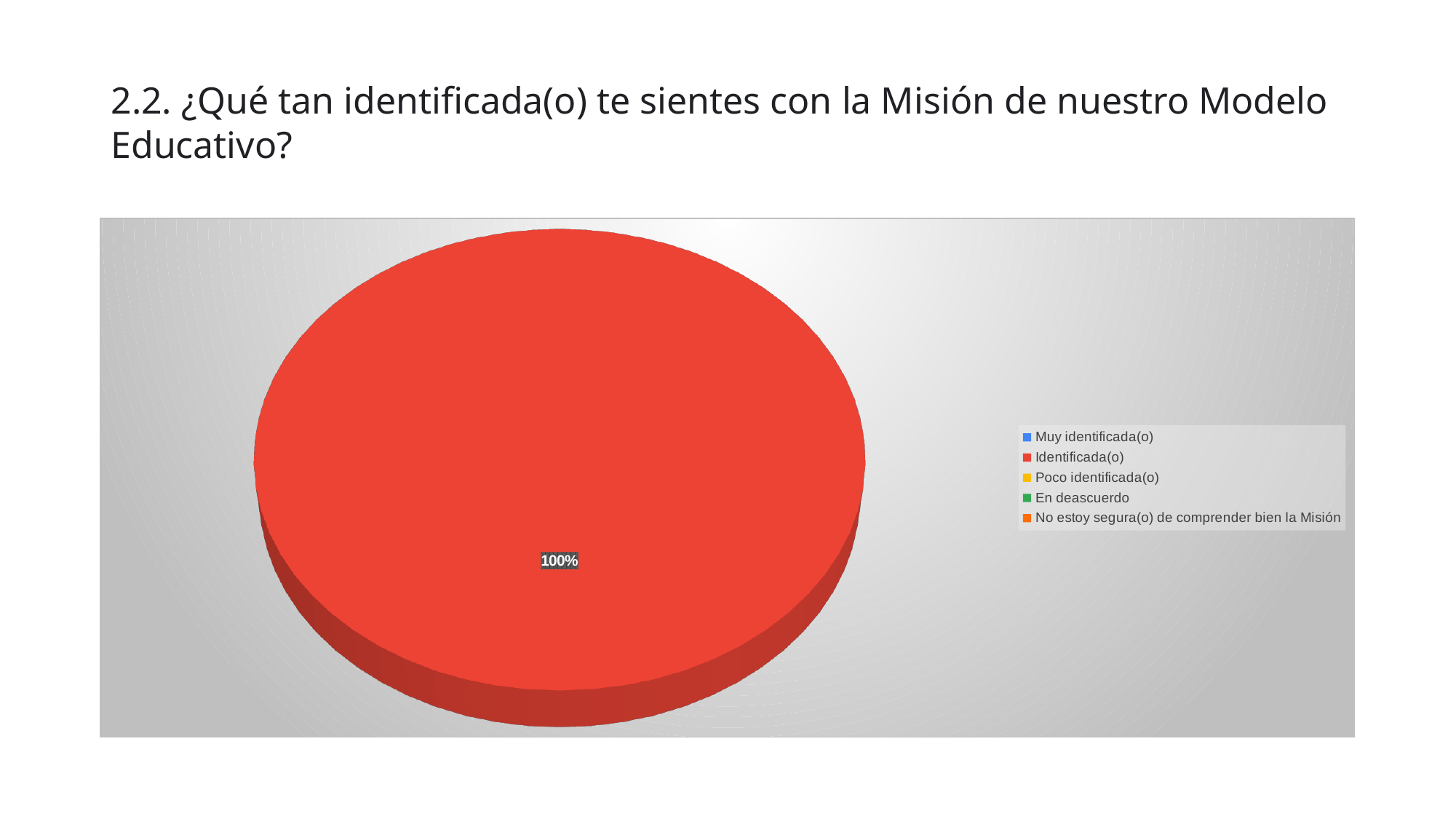
Which is larger, the share for "Identificada(o)" or the share for "Muy identificada(o)"? Identificada(o) What share of the pie does the "Identificada(o)" slice take? 100% Is the share for "Identificada(o)" greater or less than 50%? greater How many categories does the legend list? 5 Which colour represents "Identificada(o)" in the legend? Red What is the last entry listed in the legend? No estoy segura(o) de comprender bien la Misión Which category accounts for the entire pie? Identificada(o) What is the data label printed on the pie slice? 100% What kind of chart is shown on the slide? Pie chart